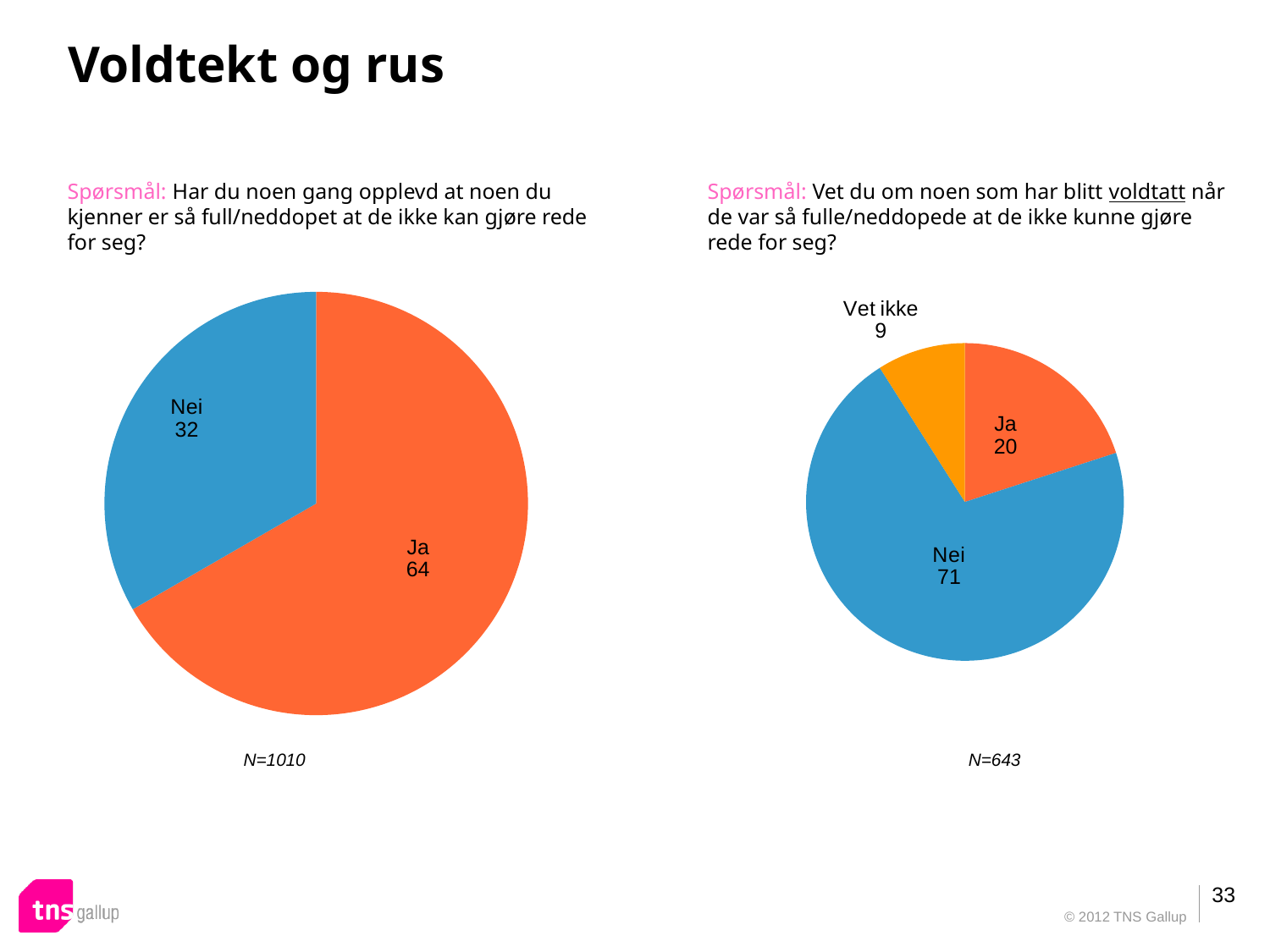
In the right pie chart, which is larger, "Ja" or "Vet ikke"? Ja In the left pie chart, which category has the largest slice? Ja How many categories does the right pie chart show? 3 In the right pie chart, what is the value for "Nei"? 71 In the right pie chart, what is the value for "Vet ikke"? 9 In the left pie chart, what is the difference between the values for "Ja" and "Nei"? 32 In the right pie chart, which category has the largest slice? Nei In the right pie chart, what is the difference between the values for "Nei" and "Ja"? 51 In the left pie chart, what is the value for "Ja"? 64 What kind of chart is the left chart on the slide? Pie chart In the left pie chart, what is the value for "Nei"? 32 In the right pie chart, which category has the smallest slice? Vet ikke